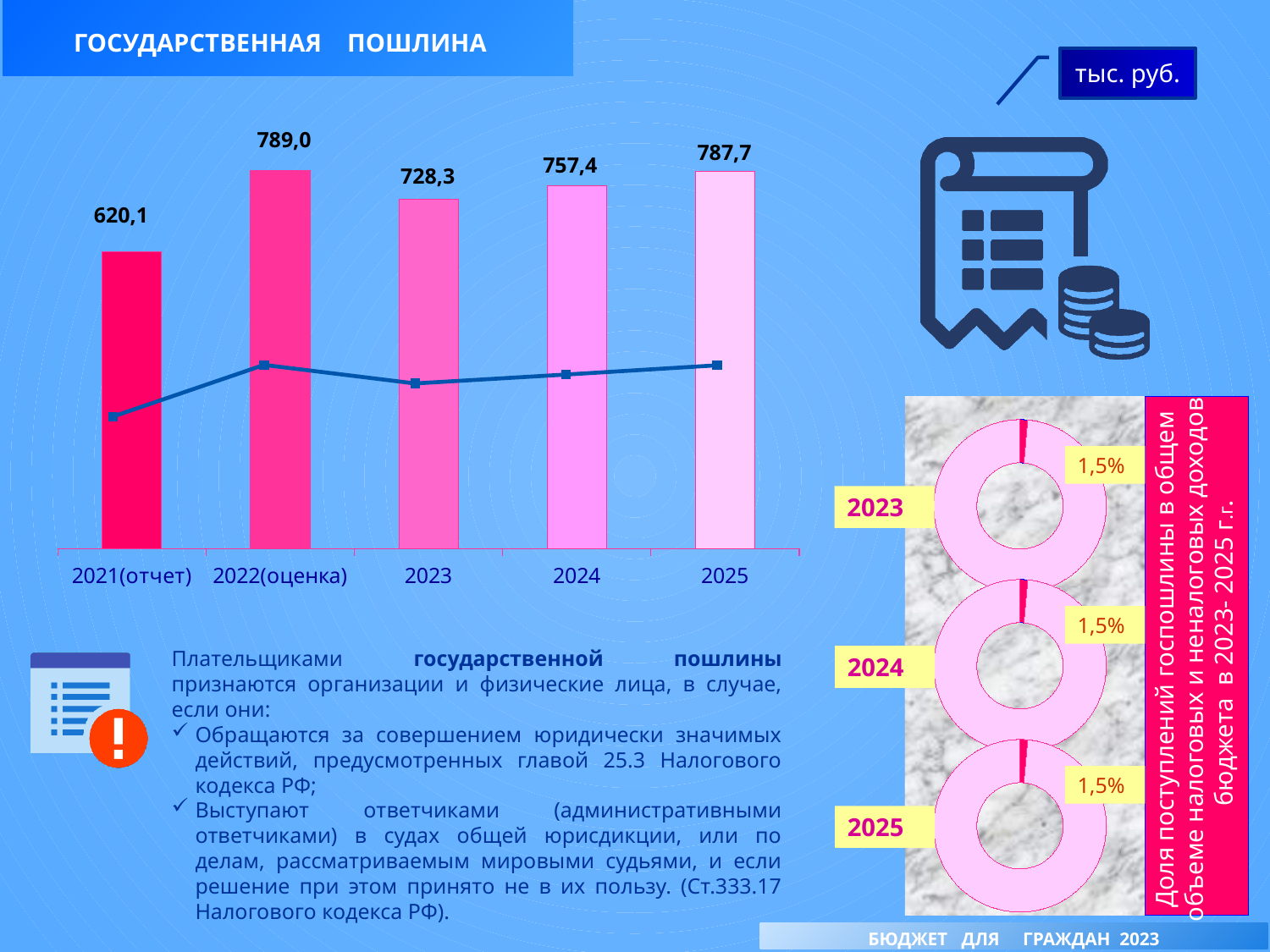
In the bar chart on the left, which category has the lowest value? 2021(отчет) In the bar chart on the left, what is the value for 2024? 757,4 In the bar chart on the left, which is larger: the value for 2023 or the value for 2025? 2025 In the bar chart on the left, which category has the highest value? 2022(оценка) How many categories are shown on the x axis of the bar chart on the left? 5 In the bar chart on the left, what is the difference between the values for 2022(оценка) and 2021(отчет)? 168,9 In the bar chart on the left, what is the value for 2021(отчет)? 620,1 What kind of chart is the large chart on the left of the slide? bar chart In the bar chart on the left, what is the value for 2025? 787,7 What unit is indicated for the values in the bar chart on the left? тыс. руб. In the bar chart on the left, what is the difference between the values for 2024 and 2023? 29,1 In the donut charts on the right, what share is shown for 2024? 1,5%